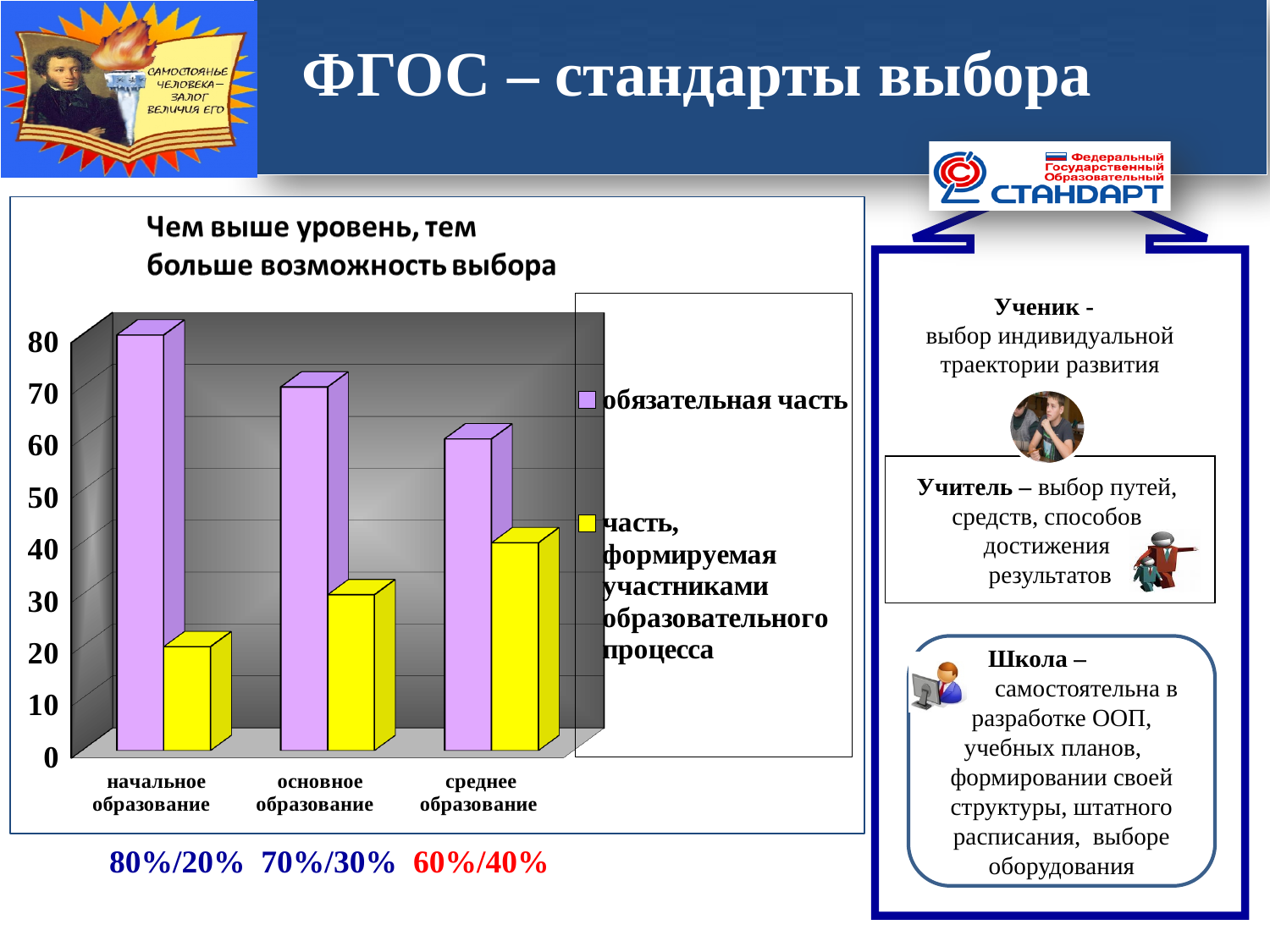
Do the values of обязательная часть rise or fall from начальное образование to среднее образование? fall How many education-level categories are shown on the x axis of the chart? 3 What is the value of обязательная часть for основное образование? 70 Which category has the lowest value for часть, формируемая участниками образовательного процесса? начальное образование What is the value of обязательная часть for начальное образование? 80 Which is larger for среднее образование: обязательная часть or часть, формируемая участниками образовательного процесса? обязательная часть What kind of chart is shown on the slide? bar chart How many series does the chart legend list? 2 What colour are the bars for обязательная часть in the chart? purple What is the value of часть, формируемая участниками образовательного процесса for среднее образование? 40 Which category has the highest value for обязательная часть? начальное образование What is the difference between обязательная часть and часть, формируемая участниками образовательного процесса for основное образование? 40